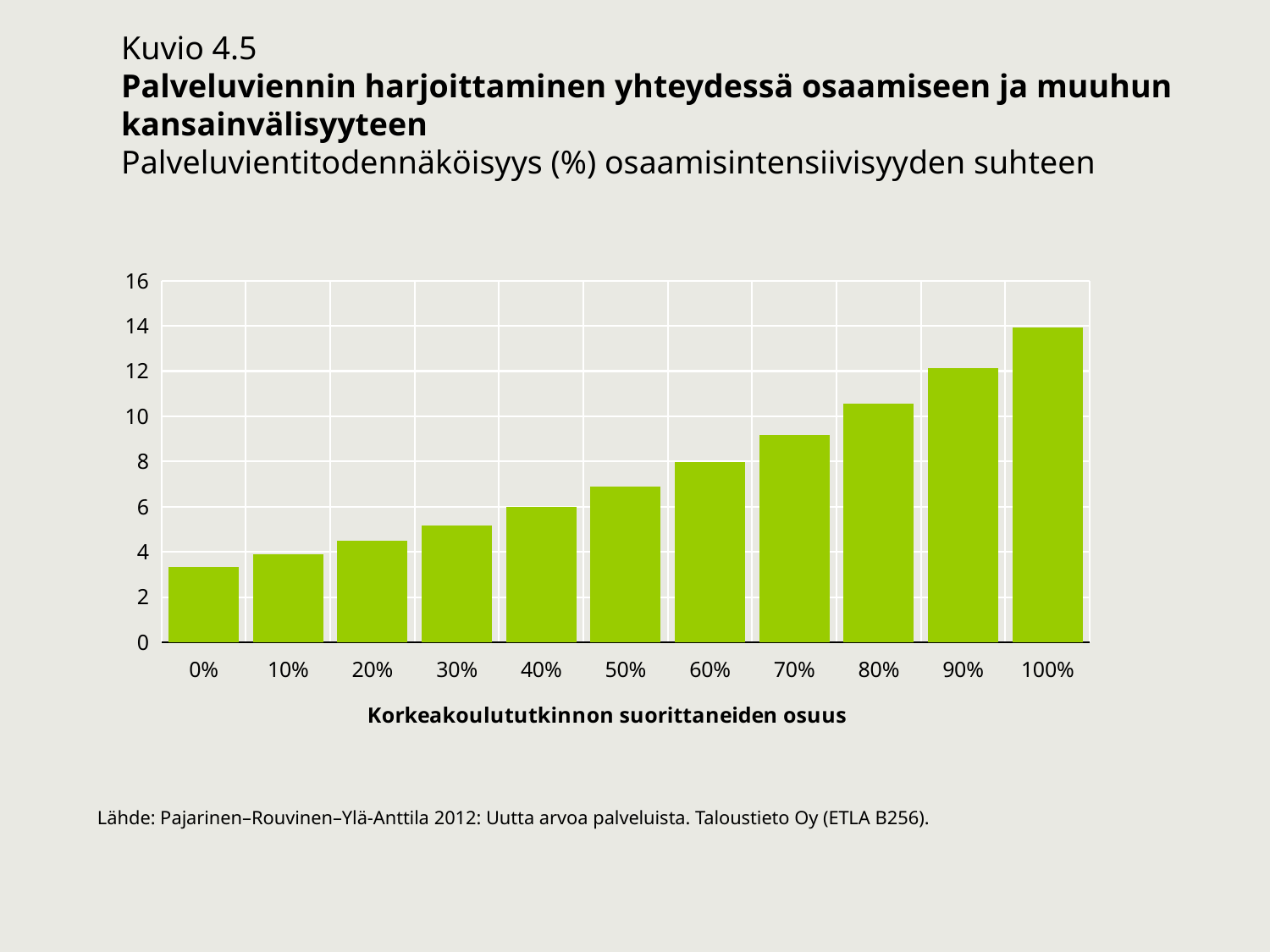
Which category has the lowest bar in the chart? 0% Which category has the highest bar in the chart? 100% How many categories are shown on the x axis of the chart? 11 Is the value for 50% greater or less than 8? less Do the values rise or fall as the share of degree holders increases along the x axis? rise What is the title of the x axis of the chart? Korkeakoulututkinnon suorittaneiden osuus Is the value for 100% greater or less than 12? greater Which is larger, the value for 70% or the value for 30%? 70% What kind of chart is shown on the slide? bar chart Is the value for 80% greater or less than 10? greater What colour are the bars in the chart? green